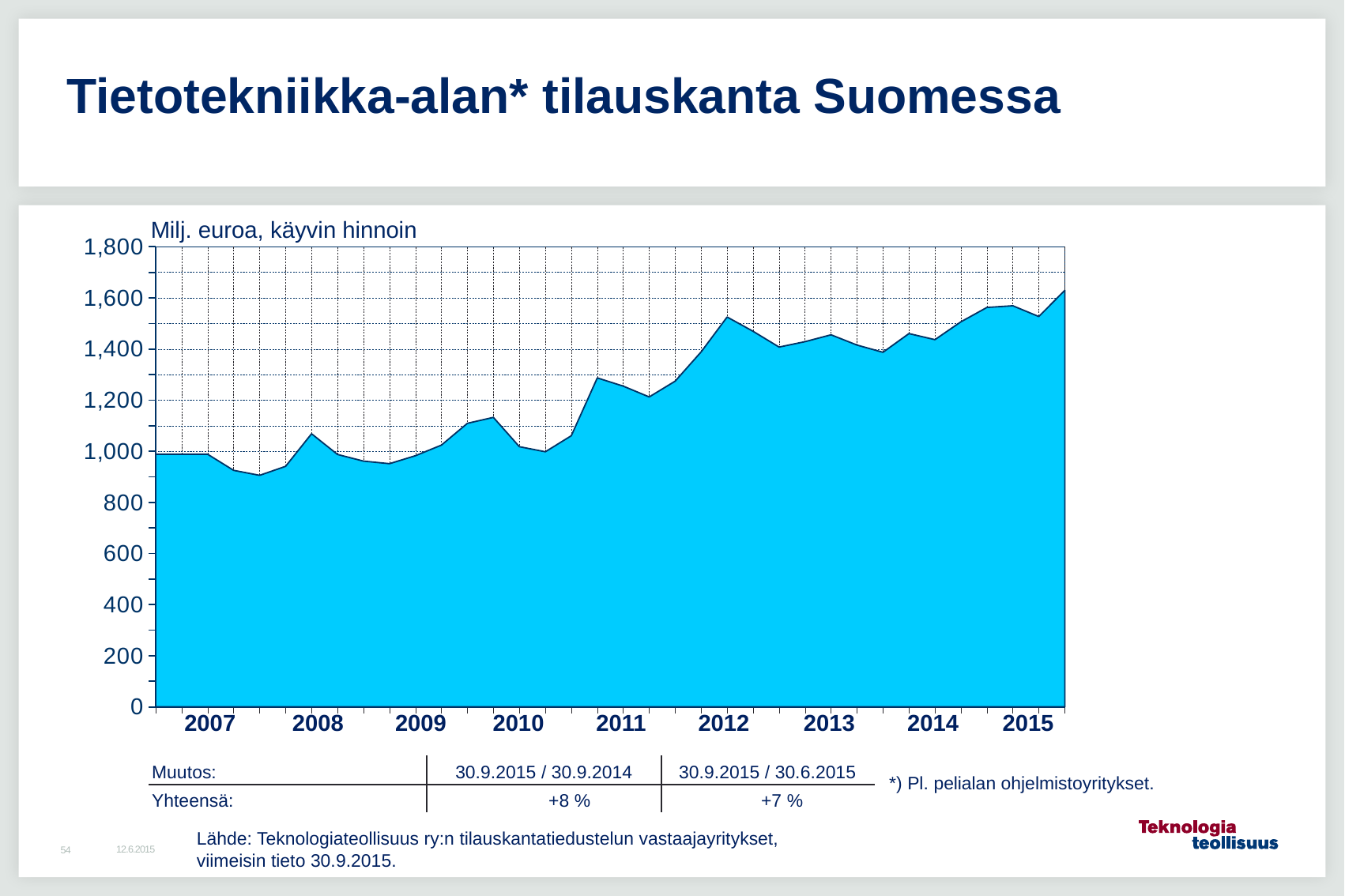
What kind of chart is shown on the slide? Area chart What is the title of the slide's chart? Tietotekniikka-alan* tilauskanta Suomessa Which is larger, the value at the start of 2007 or the value at the end of 2015? End of 2015 Overall, do the values rise or fall from 2007 to 2015? Rise Which is larger, the value at the start of 2012 or the value at the start of 2010? 2012 In which year does the chart reach its highest value? 2015 Is the value at the start of 2011 greater or less than 1,200? greater How many years are labelled on the x axis of the chart? 9 Is the lowest value on the chart greater or less than 1,000? less Is the value at the end of 2015 greater or less than 1,400? greater What unit label is shown above the chart's y axis? Milj. euroa, käyvin hinnoin